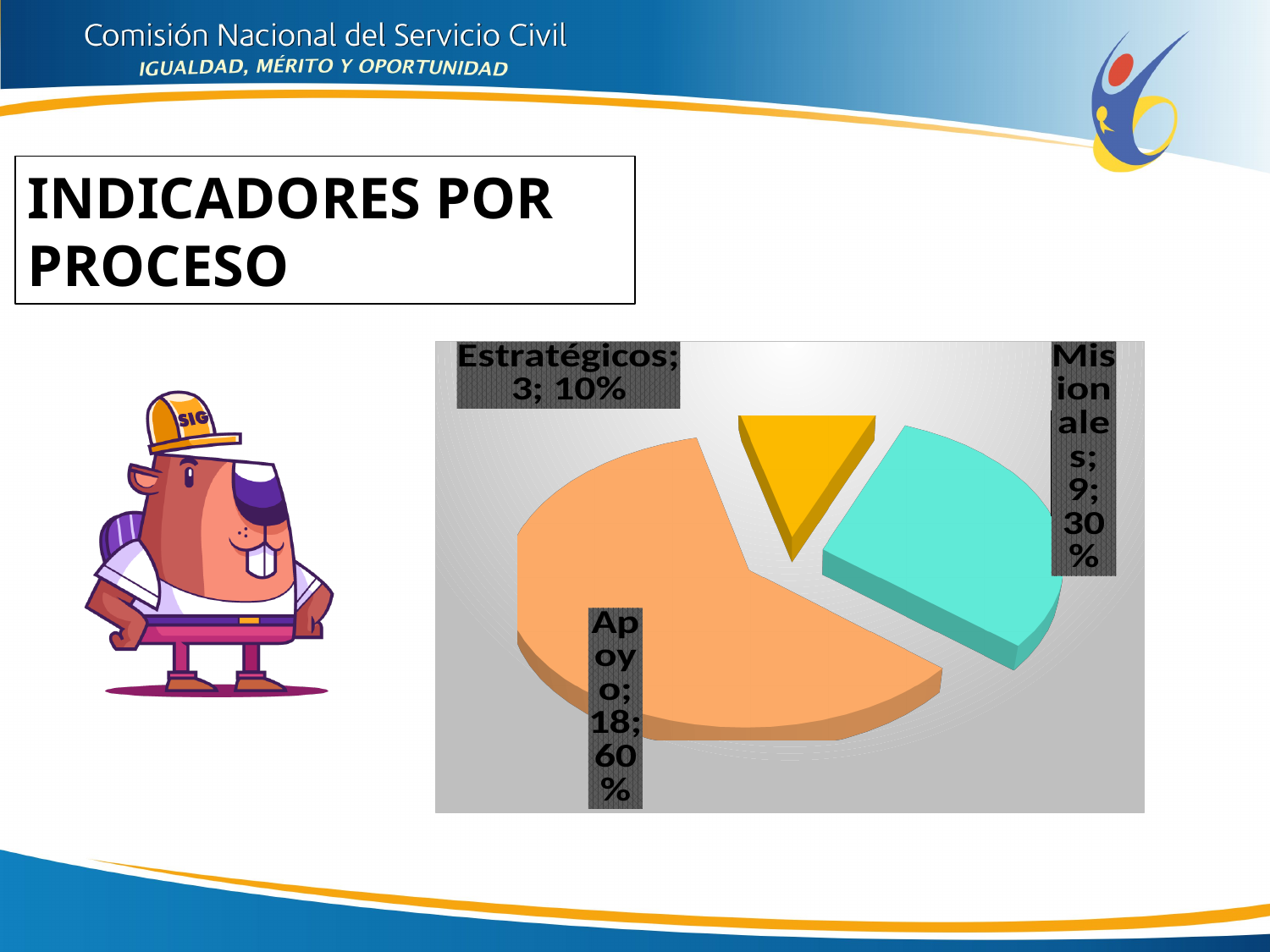
How many slices does the pie chart have? 3 What kind of chart is shown on the slide? Pie chart Which category has the smallest share of the pie? Estratégicos Which category has the largest share of the pie? Apoyo What colour is the Misionales slice? Turquoise What is the total number of indicators across all three categories? 30 Which has more indicators, Misionales or Estratégicos? Misionales What percentage of the pie does the Misionales slice represent? 30% What percentage of the pie does the Apoyo slice represent? 60% How many indicators are in the Estratégicos category? 3 What is the difference in the number of indicators between Apoyo and Misionales? 9 How many indicators are in the Apoyo category? 18